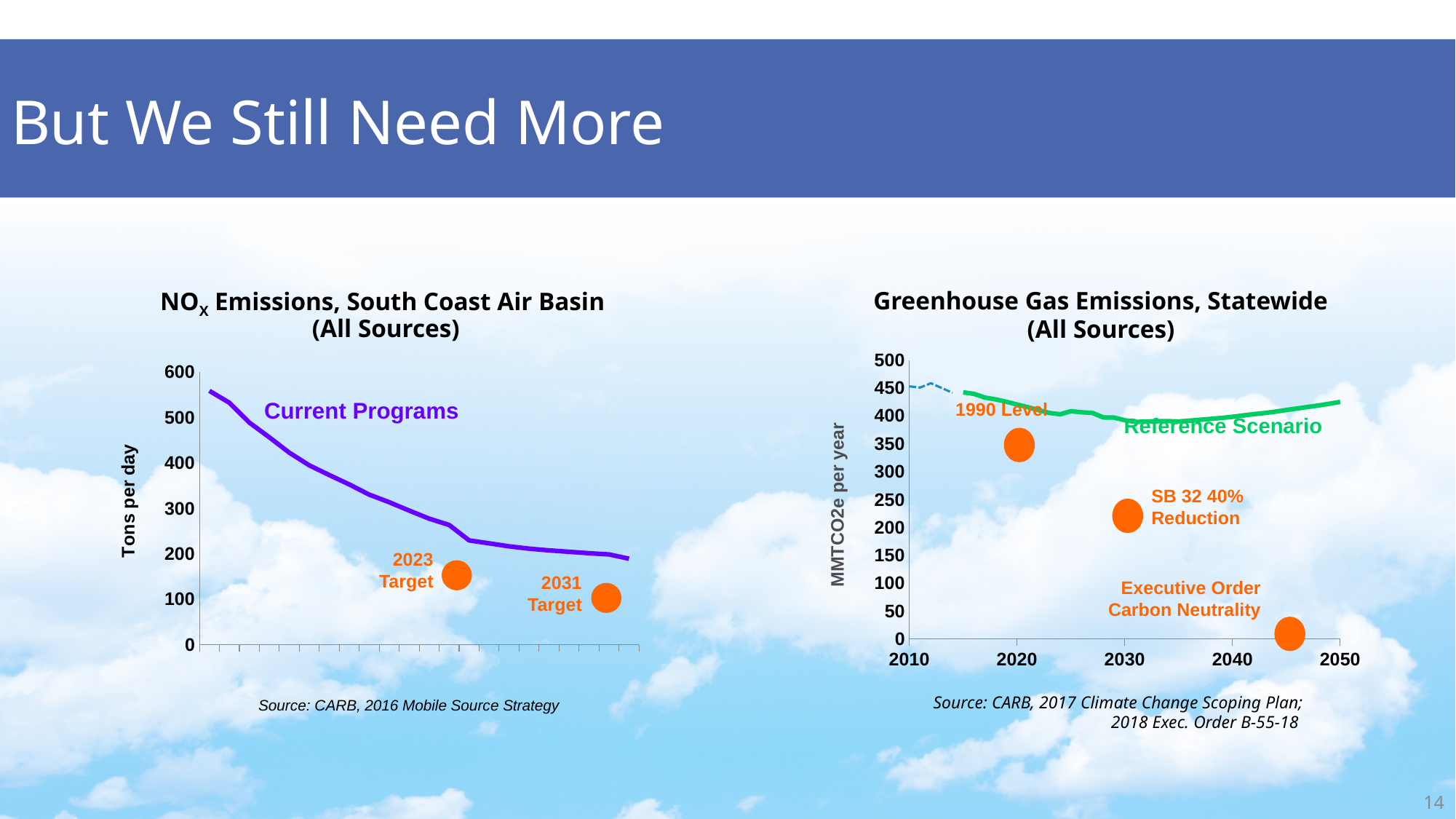
In the NOx Emissions, South Coast Air Basin chart, does the Current Programs line rise or fall along the x axis? fall In the NOx Emissions, South Coast Air Basin chart, is the starting value of the Current Programs line greater or less than 500? greater In the Greenhouse Gas Emissions, Statewide chart, is the SB 32 40% Reduction value greater or less than 300? less In the Greenhouse Gas Emissions, Statewide chart, is the 1990 Level value greater or less than 300? greater In the Greenhouse Gas Emissions, Statewide chart, which is larger, the 1990 Level value or the SB 32 40% Reduction value? 1990 Level What is the y-axis label of the Greenhouse Gas Emissions, Statewide chart? MMTCO2e per year What kind of chart is the NOx Emissions, South Coast Air Basin chart? line chart What is the y-axis label of the NOx Emissions, South Coast Air Basin chart? Tons per day What kind of chart is the Greenhouse Gas Emissions, Statewide chart? line chart